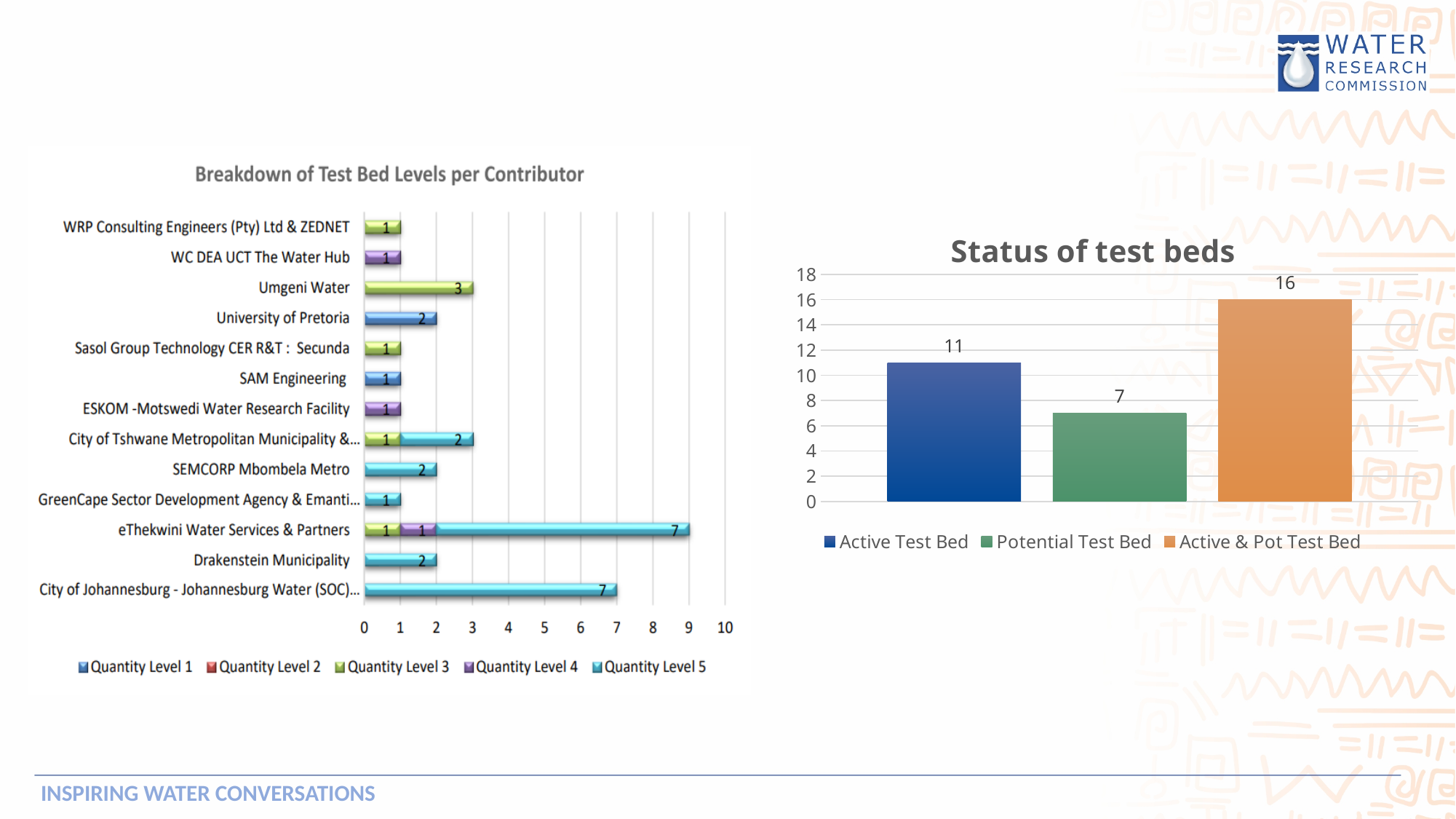
In the 'Breakdown of Test Bed Levels per Contributor' chart, how many contributors are listed on the vertical axis? 13 What kind of chart is 'Status of test beds'? Bar chart In the 'Breakdown of Test Bed Levels per Contributor' chart, which is larger: the bar for City of Johannesburg - Johannesburg Water (SOC) or the bar for Drakenstein Municipality? City of Johannesburg - Johannesburg Water (SOC) In the 'Status of test beds' chart, what is the difference between Active & Pot Test Bed and Active Test Bed? 5 In the 'Status of test beds' chart, which category has the lowest value? Potential Test Bed In the 'Status of test beds' chart, which category has the highest value? Active & Pot Test Bed In the 'Status of test beds' chart, what is the value for Potential Test Bed? 7 In the 'Breakdown of Test Bed Levels per Contributor' chart, what is the total of the stacked bar for eThekwini Water Services & Partners? 9 In the 'Status of test beds' chart, how many bars are plotted? 3 In the 'Breakdown of Test Bed Levels per Contributor' chart, what is the value shown for Umgeni Water? 3 In the 'Breakdown of Test Bed Levels per Contributor' chart, how many series does the legend list? 5 In the 'Status of test beds' chart, what is the value for Active Test Bed? 11